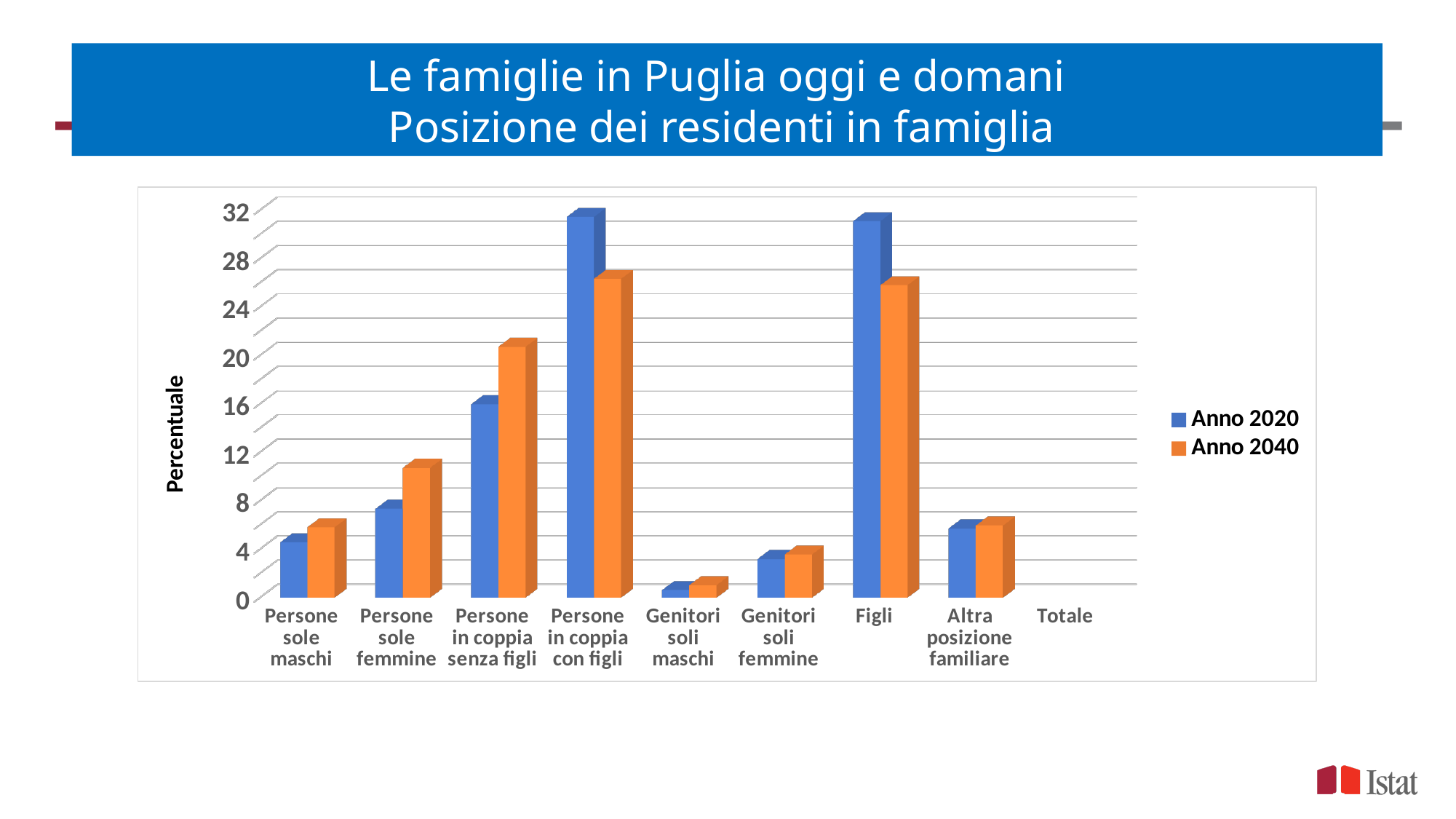
How many category labels are shown along the x axis? 9 What are the two series named in the legend? Anno 2020 and Anno 2040 Is the Anno 2040 value for Persone in coppia senza figli greater or less than 16? greater For Persone in coppia senza figli, which series has the larger value, Anno 2020 or Anno 2040? Anno 2040 How many series does the legend list? 2 Which category has the lowest value for Anno 2020? Genitori soli maschi For Persone in coppia con figli, which series has the larger value, Anno 2020 or Anno 2040? Anno 2020 What kind of chart is shown on the slide? bar chart For Persone sole femmine, which series has the larger value, Anno 2020 or Anno 2040? Anno 2040 What is the label of the vertical axis? Percentuale Is the Anno 2020 value for Persone in coppia con figli greater or less than 28? greater Which category has the lowest value for Anno 2040? Genitori soli maschi